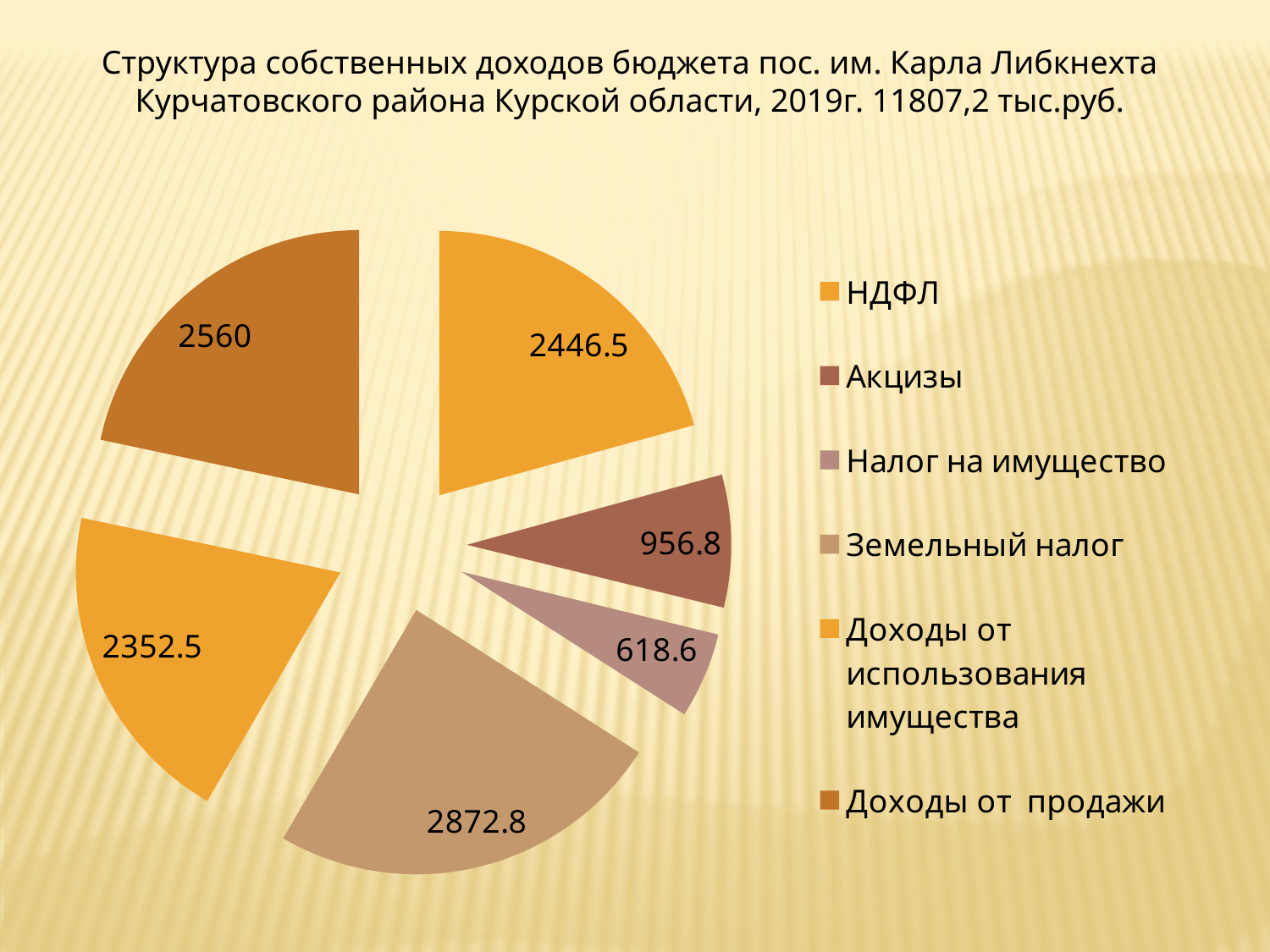
What is the value for Налог на имущество? 618.6 What is the difference between the values for Акцизы and Налог на имущество? 338.2 What is the value for Доходы от продажи? 2560 Which category has the largest slice of the pie? Земельный налог What type of chart is shown on the slide? pie chart How many categories does the legend list? 6 What is the difference between the values for Земельный налог and Налог на имущество? 2254.2 Which category has the smallest slice of the pie? Налог на имущество What is the value for Земельный налог? 2872.8 What is the value for НДФЛ? 2446.5 Which is larger, Доходы от продажи or НДФЛ? Доходы от продажи What is the value for Акцизы? 956.8